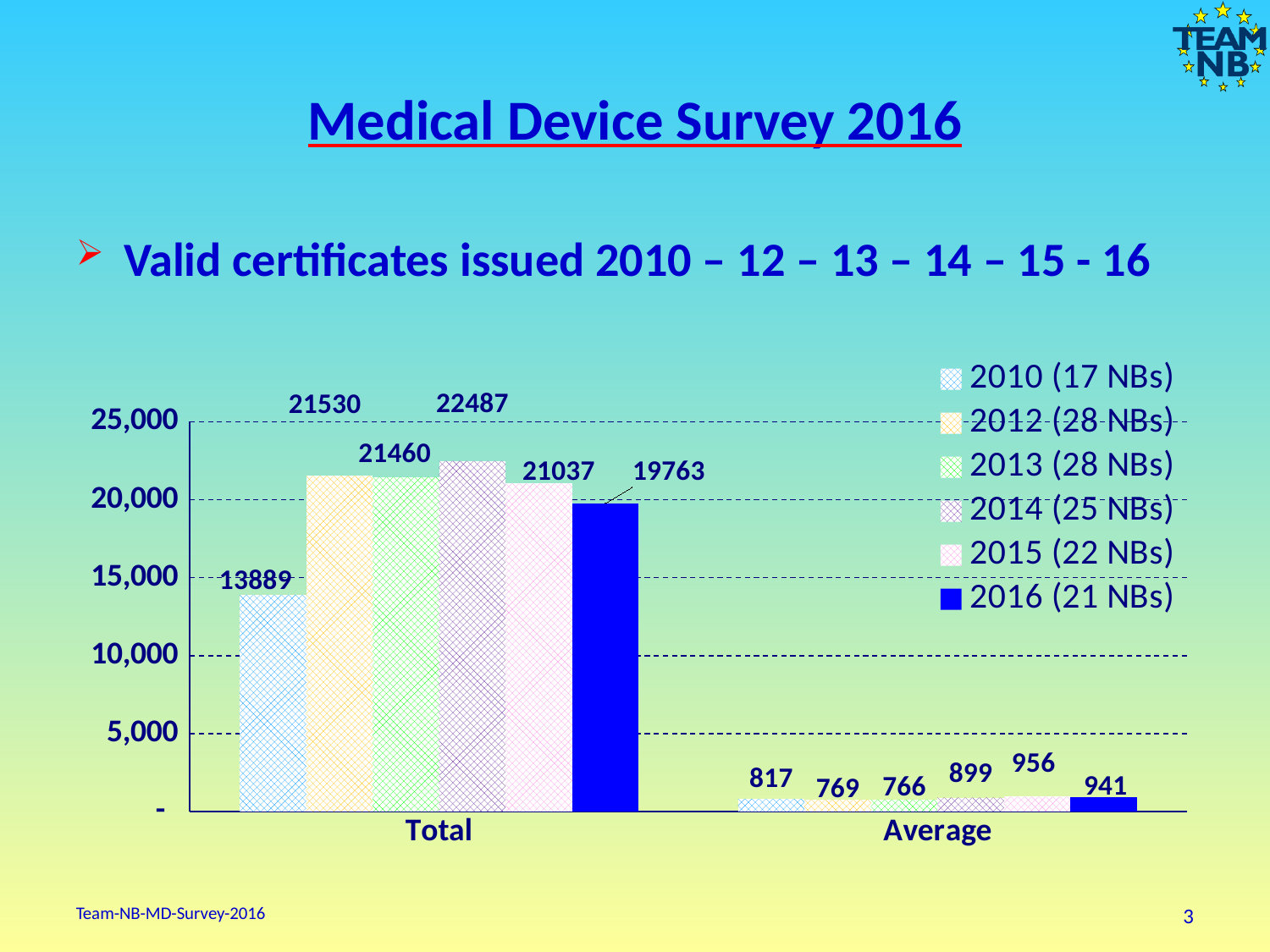
Is the Total value for 2016 (21 NBs) greater or less than 20,000? less What is the Total value for the 2010 (17 NBs) series? 13889 What is the Average value for the 2015 (22 NBs) series? 956 What kind of chart is shown on the slide? bar chart Which series has the lowest Total value? 2010 (17 NBs) How many series does the legend list? 6 Which is larger, the Average value for 2010 (17 NBs) or for 2012 (28 NBs)? 2010 (17 NBs) What is the Average value for the 2013 (28 NBs) series? 766 Which series has the highest Total value? 2014 (25 NBs) What is the Total value for the 2016 (21 NBs) series? 19763 What is the difference between the Total values for 2014 (25 NBs) and 2016 (21 NBs)? 2724 Which series has the highest Average value? 2015 (22 NBs)